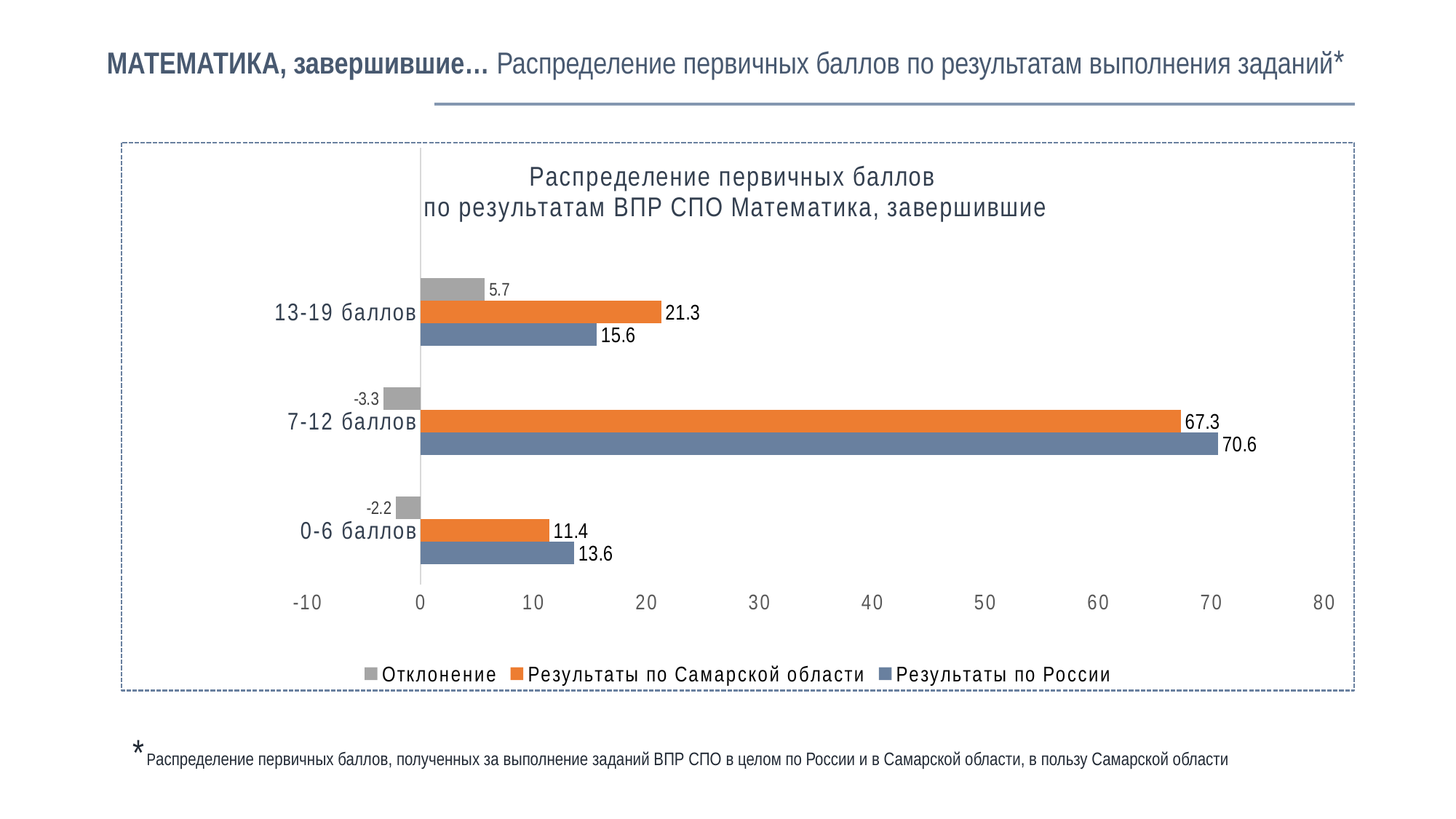
What is the value for "Отклонение" in the "7-12 баллов" category? -3.3 What is the value for "Результаты по Самарской области" in the "7-12 баллов" category? 67.3 In the "13-19 баллов" category, which is larger: "Результаты по Самарской области" or "Результаты по России"? Результаты по Самарской области What is the value for "Отклонение" in the "13-19 баллов" category? 5.7 What is the value for "Результаты по России" in the "0-6 баллов" category? 13.6 What kind of chart is shown on the slide? Bar chart How many categories are shown on the chart? 3 Which category has the highest value for "Результаты по России"? 7-12 баллов How many series does the legend list? 3 What colour are the bars for "Результаты по Самарской области"? Orange What is the difference between "Результаты по России" and "Результаты по Самарской области" in the "7-12 баллов" category? 3.3 Which category has the lowest value for "Результаты по Самарской области"? 0-6 баллов